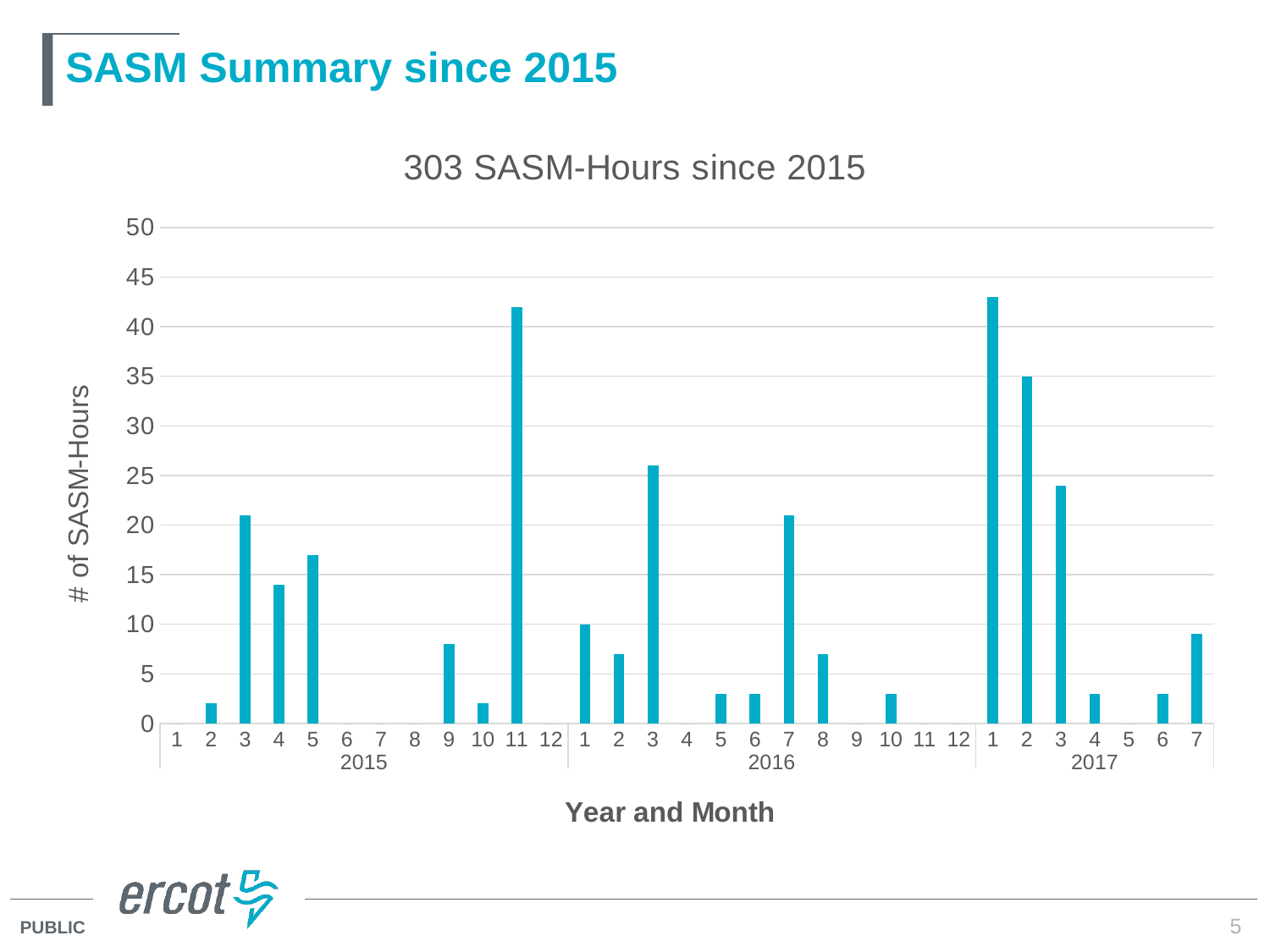
Which is larger: the value for month 2 of 2017 or the value for month 3 of 2016? month 2 of 2017 What type of chart is shown on the slide? bar chart Is the value for month 2 of 2017 greater or less than 30? greater Which is larger: the value for month 5 of 2015 or the value for month 4 of 2015? month 5 of 2015 What is the label on the vertical axis of the chart? # of SASM-Hours Is the value for month 1 of 2016 greater or less than 15? less What is the title of the chart? 303 SASM-Hours since 2015 How many year-month categories are shown along the x axis of the chart? 31 Which month of 2016 has the highest number of SASM-Hours? 3 Is the value for month 9 of 2015 greater or less than 10? less